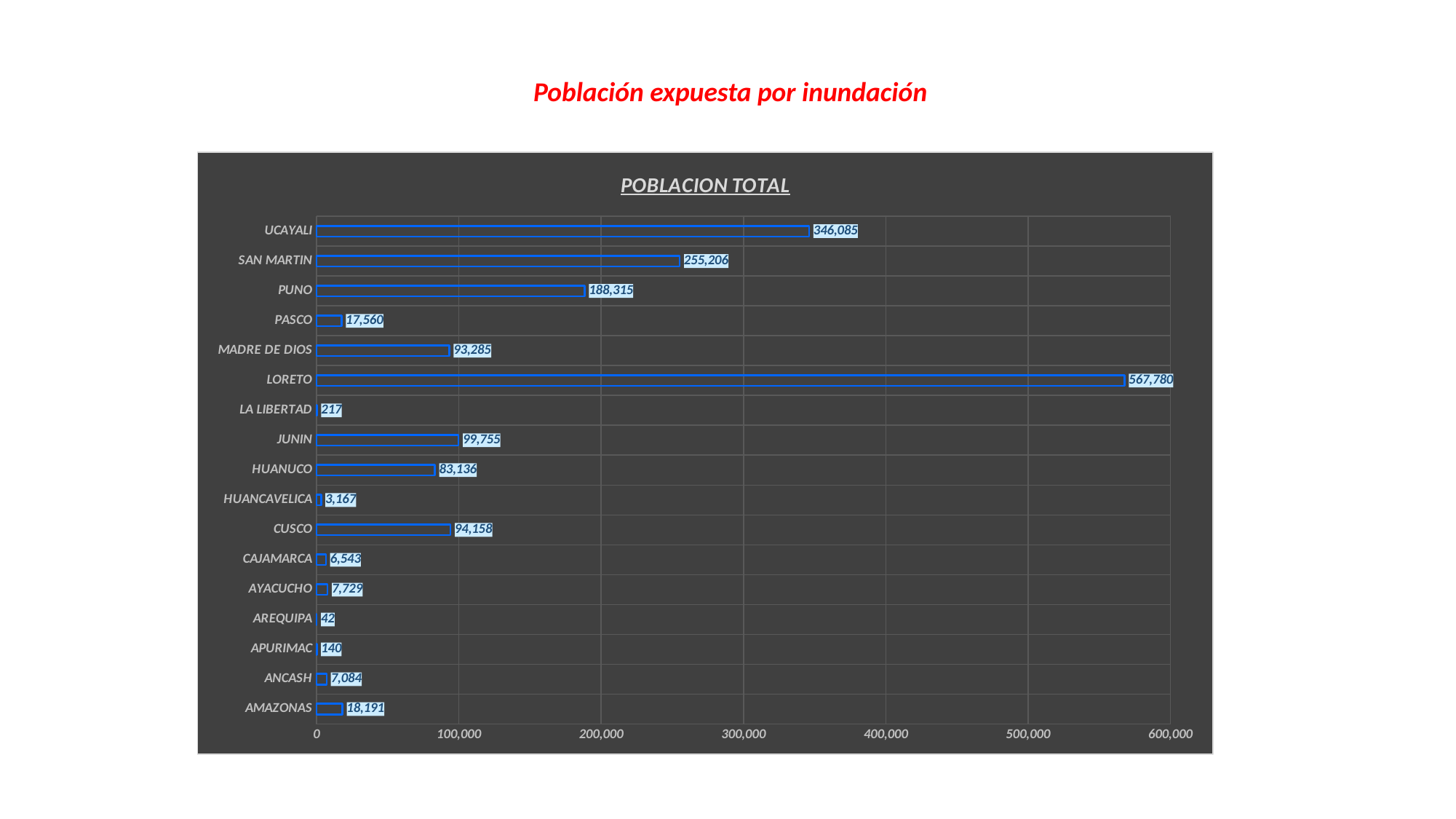
What is the value for UCAYALI? 346,085 How many categories are shown on the chart? 17 What is the title of the chart? POBLACION TOTAL Which is larger, the value for CUSCO or the value for MADRE DE DIOS? CUSCO Which category has the highest value? LORETO What is the value for LORETO? 567,780 What is the value for HUANCAVELICA? 3,167 What is the difference between the values for LORETO and UCAYALI? 221,695 What is the difference between the values for JUNIN and HUANUCO? 16,619 Is the value for SAN MARTIN greater or less than 200,000? greater Which category has the lowest value? AREQUIPA What kind of chart is shown? bar chart